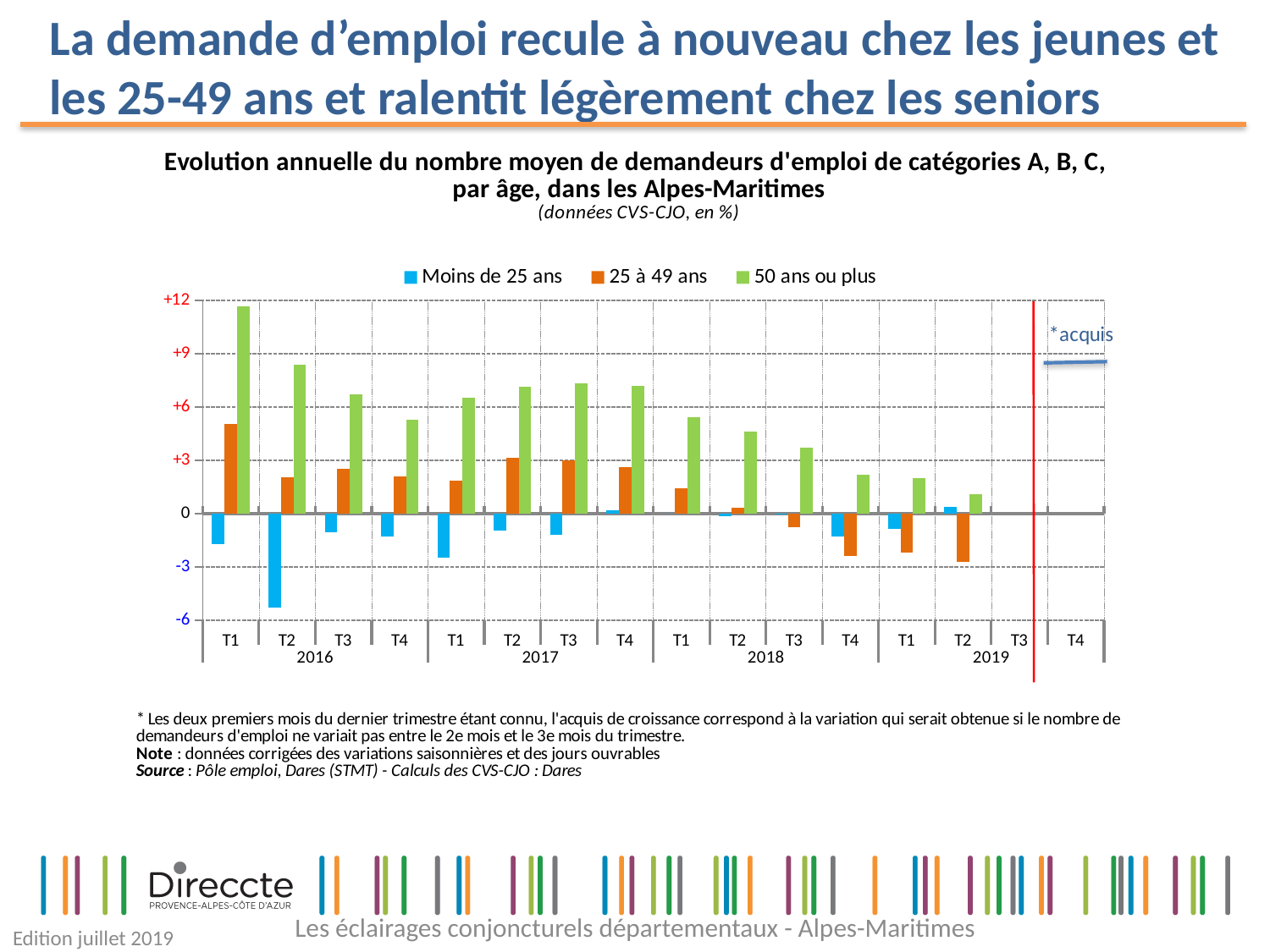
Is the value for 50 ans ou plus in T1 2016 greater or less than +9? greater Is the value for Moins de 25 ans in T2 2016 greater or less than -3? less In T1 2016, which is larger: the value for 25 à 49 ans or the value for 50 ans ou plus? 50 ans ou plus How many series does the legend list? 3 Is the value for 25 à 49 ans in T1 2016 greater or less than +3? greater In which quarter is the value for Moins de 25 ans the lowest? T2 2016 In which quarter is the value for 50 ans ou plus the highest? T1 2016 What are the three series named in the legend? Moins de 25 ans, 25 à 49 ans, 50 ans ou plus What kind of chart is shown on the slide? bar chart Do the values for 50 ans ou plus rise or fall from T1 2018 to T2 2019? fall How many years are labelled on the x axis of the chart? 4